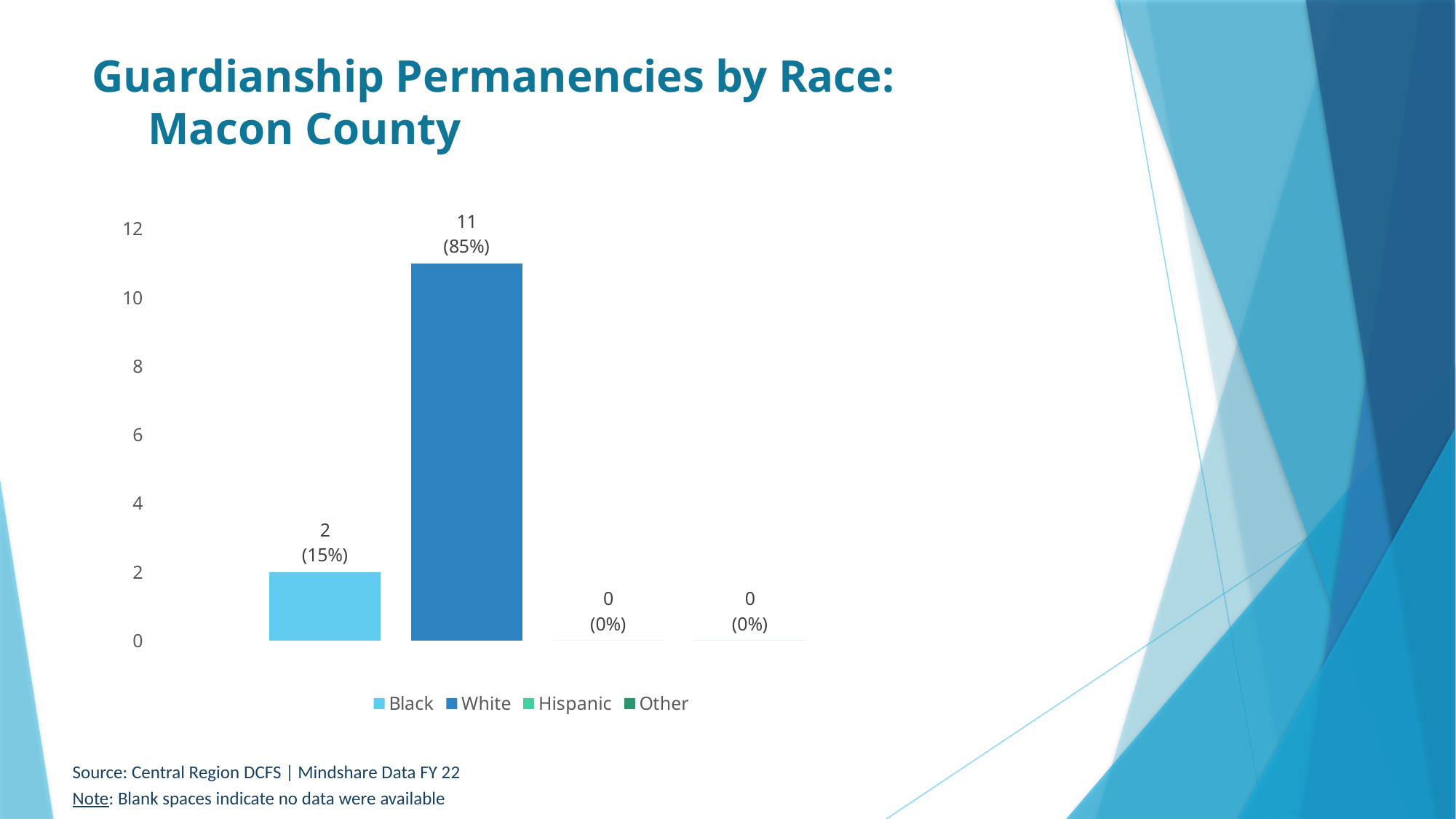
What percentage is shown for White? 85% Which is larger, the value for Black or the value for White? White How many categories does the legend list? 4 What kind of chart is shown on the slide? bar chart What is the value for Hispanic? 0 Is the value for White greater or less than 10? greater What percentage is shown for Black? 15% What is the difference between the values for White and Black? 9 Which category has the highest value? White What is the title of the slide? Guardianship Permanencies by Race: Macon County What is the value for Black? 2 What is the value for White? 11